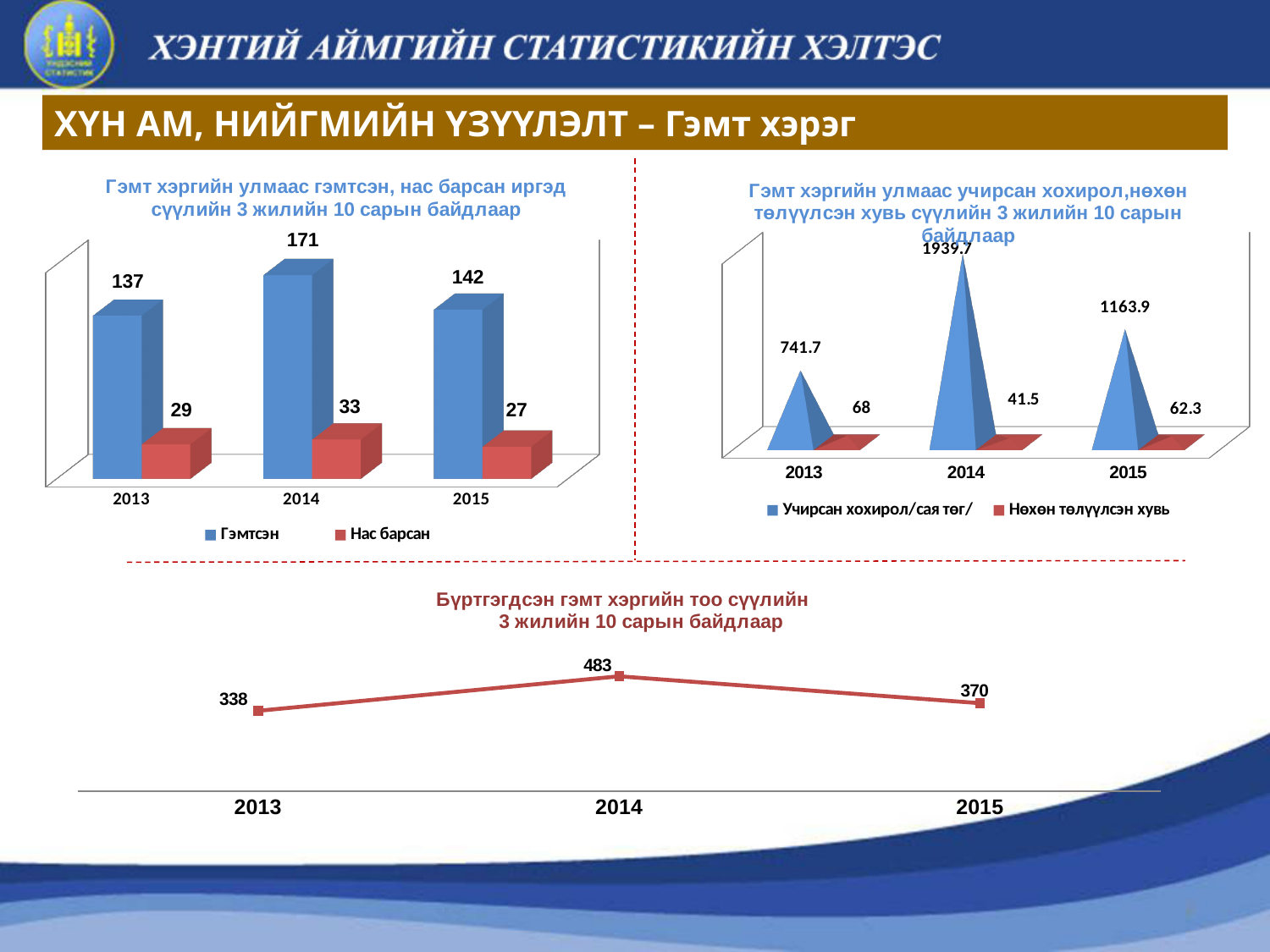
How many data points are plotted in the bottom chart? 3 How many series does the legend of the top-left chart list? 2 In the top-left chart, what is the value for Нас барсан in 2015? 27 In the top-left chart, what is the value for Гэмтсэн in 2014? 171 In the top-left chart, what is the difference between the Гэмтсэн values for 2014 and 2013? 34 In the top-right chart, what is the value for Учирсан хохирол/сая төг/ in 2014? 1939.7 What kind of chart is the top-left chart? bar chart In the bottom chart, what is the value for 2014? 483 In the bottom chart, which is larger, the value for 2013 or the value for 2015? 2015 In the top-left chart, which year has the highest value for Гэмтсэн? 2014 In the top-right chart, what is the value for Нөхөн төлүүлсэн хувь in 2013? 68 In the top-right chart, which year has the lowest value for Учирсан хохирол/сая төг/? 2013